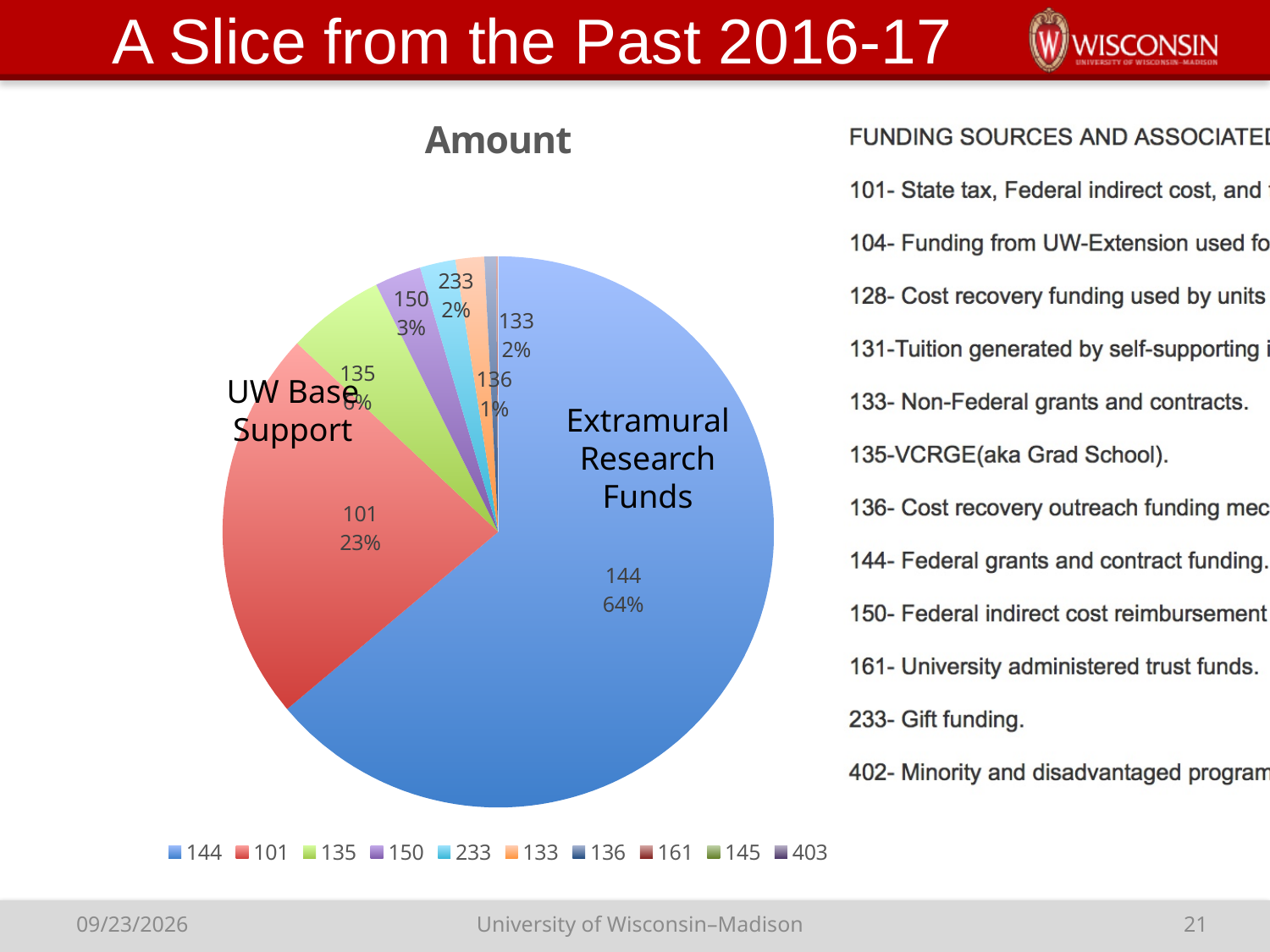
What is the title of the chart? Amount What kind of chart is shown on the slide? pie chart What share of the pie does fund 144 represent? 64% Which slice is larger, fund 101 or fund 150? 101 What share of the pie does fund 136 represent? 1% What text label is placed on the largest slice of the pie? Extramural Research Funds What share of the pie does fund 101 represent? 23% How many fund categories does the chart's legend list? 10 By how many percentage points does the share of fund 144 exceed the share of fund 101? 41 percentage points Which fund has the largest slice of the pie? 144